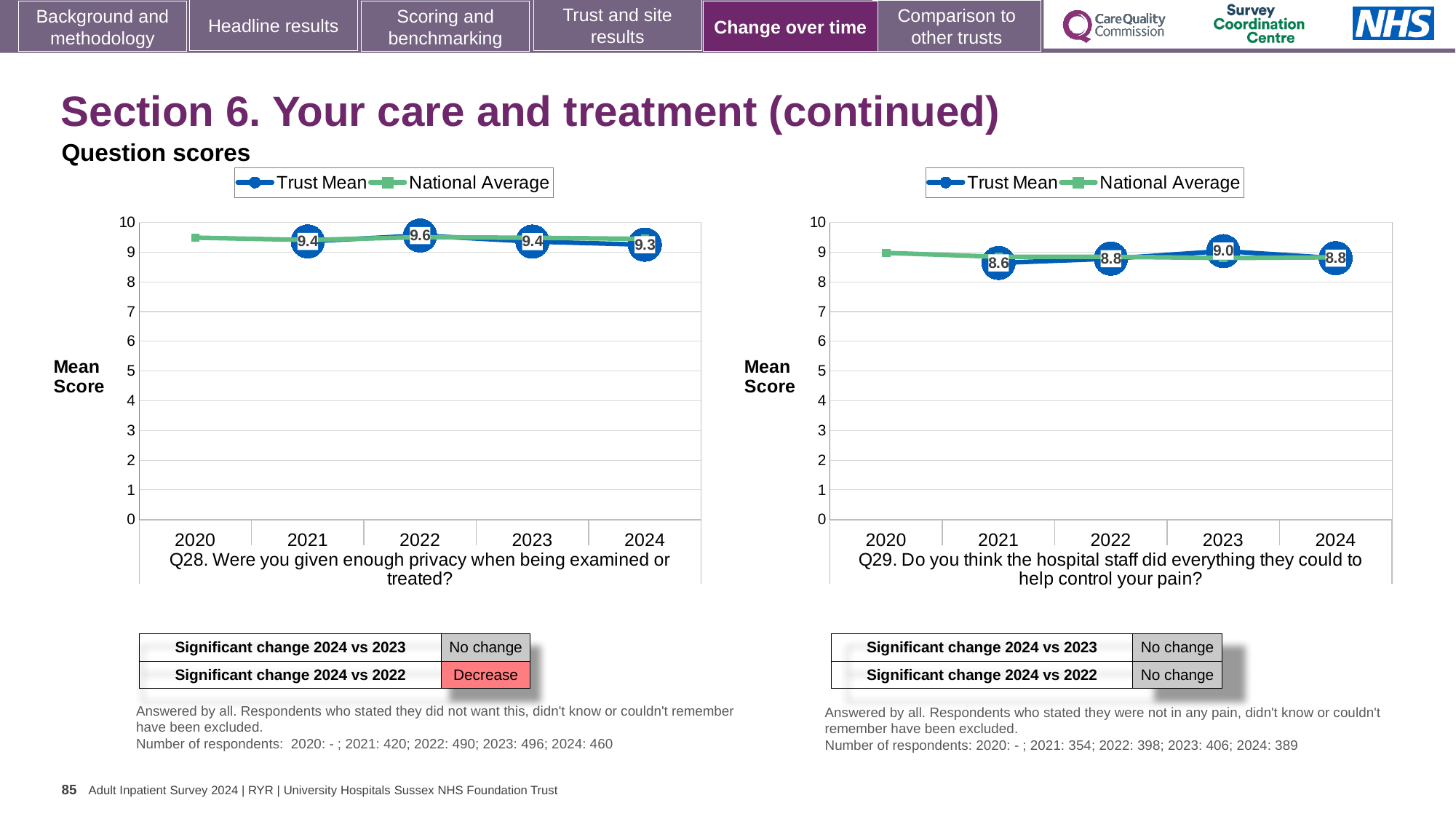
In the Q29 chart (right), what is the Trust Mean for 2023? 9.0 In the Q29 chart (right), which year has the lowest Trust Mean? 2021 What type of chart is used for Q28 (left)? Line chart How many series does the legend of the Q29 chart (right) list? 2 In the Q28 chart (left), which year has the highest Trust Mean? 2022 In the Q29 chart (right), is the National Average for 2020 greater or less than 8? greater In the Q28 chart (left), what is the Trust Mean for 2024? 9.3 In the Q29 chart (right), is the Trust Mean higher in 2023 or in 2021? 2023 In the Q28 chart (left), what is the Trust Mean for 2022? 9.6 In the Q28 chart (left), what is the difference between the Trust Mean in 2022 and in 2024? 0.3 How many years are shown on the x axis of the Q28 chart (left)? 5 In the Q29 chart (right), what is the Trust Mean for 2021? 8.6